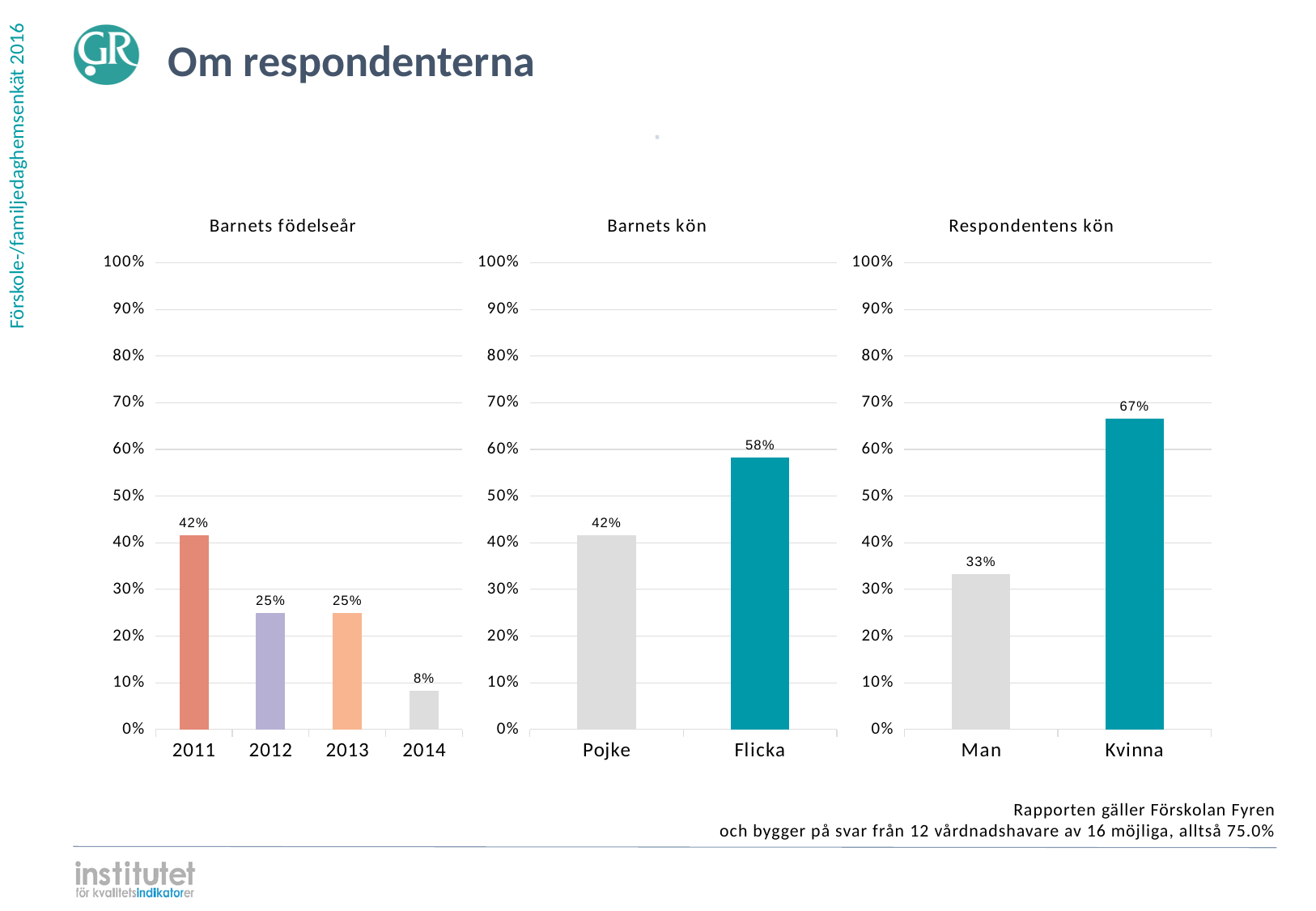
In the 'Barnets födelseår' chart, what is the difference between the values for 2011 and 2014? 34% In the 'Barnets födelseår' chart, which birth year has the lowest value? 2014 In the 'Barnets kön' chart, which category is higher, Pojke or Flicka? Flicka In the 'Barnets födelseår' chart, what is the value for 2011? 42% What kind of chart is the 'Respondentens kön' chart? Bar chart In the 'Barnets födelseår' chart, is the value for 2012 greater or less than 30%? less In the 'Barnets kön' chart, what is the value for Flicka? 58% In the 'Respondentens kön' chart, what is the value for Man? 33% In the 'Barnets födelseår' chart, how many birth years are shown? 4 In the 'Barnets kön' chart, what is the difference between Flicka and Pojke? 16% How many charts are shown on the slide? 3 In the 'Respondentens kön' chart, which category has the highest value? Kvinna